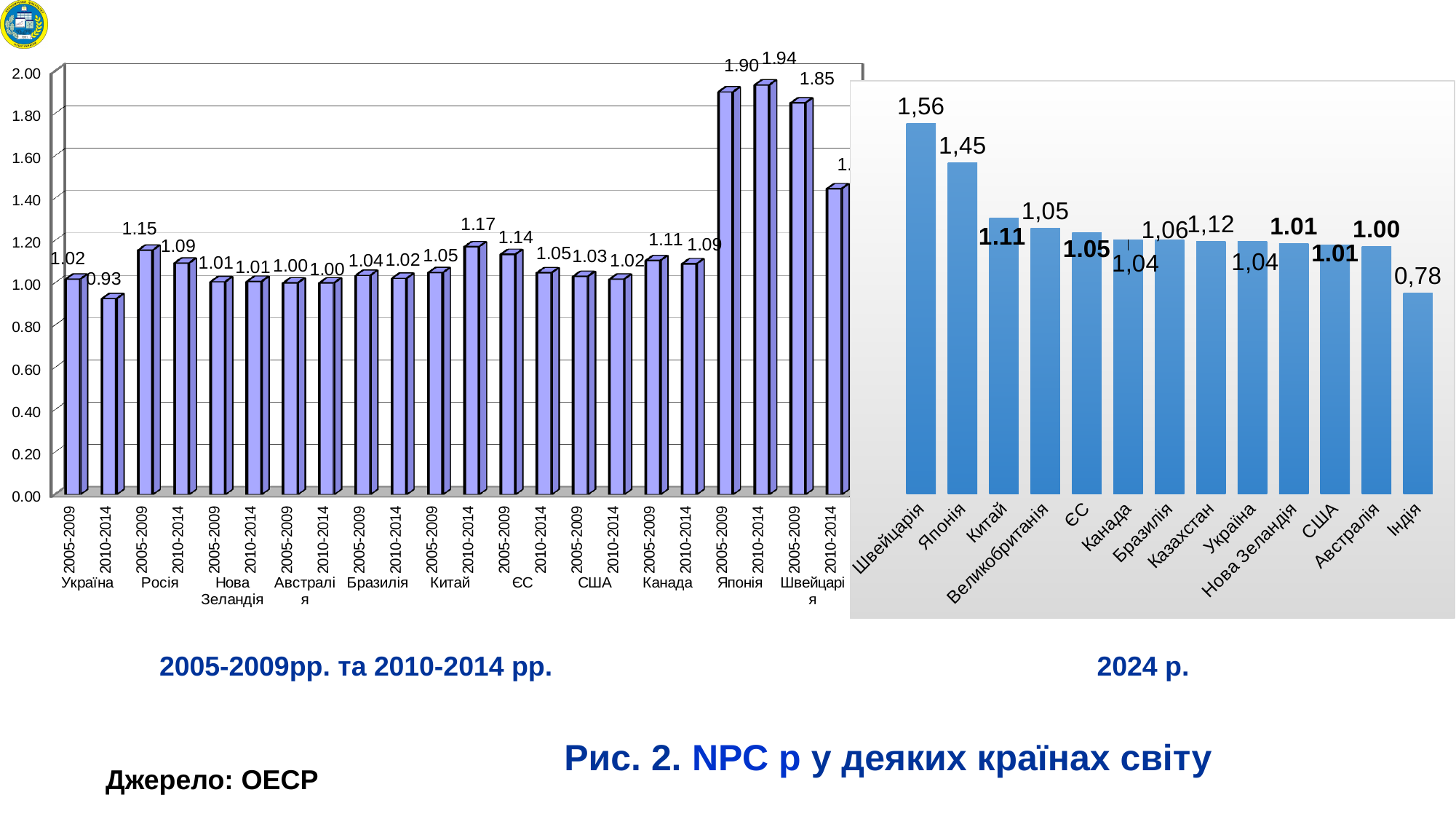
In the right chart (2024 р.), what is the value for Казахстан? 1,12 In the right chart (2024 р.), which country has the highest value? Швейцарія In the left chart (2005-2009 and 2010-2014), how many countries are shown on the x axis? 11 In the left chart (2005-2009 and 2010-2014), what is the value for Україна in 2010-2014? 0.93 In the left chart (2005-2009 and 2010-2014), which is larger: ЄС in 2005-2009 or ЄС in 2010-2014? ЄС in 2005-2009 In the left chart (2005-2009 and 2010-2014), which bar is the highest? Японія 2010-2014 In the left chart (2005-2009 and 2010-2014), what is the difference between the Росія values for 2005-2009 and 2010-2014? 0.06 In the right chart (2024 р.), which country has the lowest value? Індія In the left chart (2005-2009 and 2010-2014), what is the value for Японія in 2005-2009? 1.90 In the right chart (2024 р.), how many countries are shown? 13 What kind of chart is the right chart (2024 р.)? Bar chart In the left chart (2005-2009 and 2010-2014), what is the value for Китай in 2010-2014? 1.17